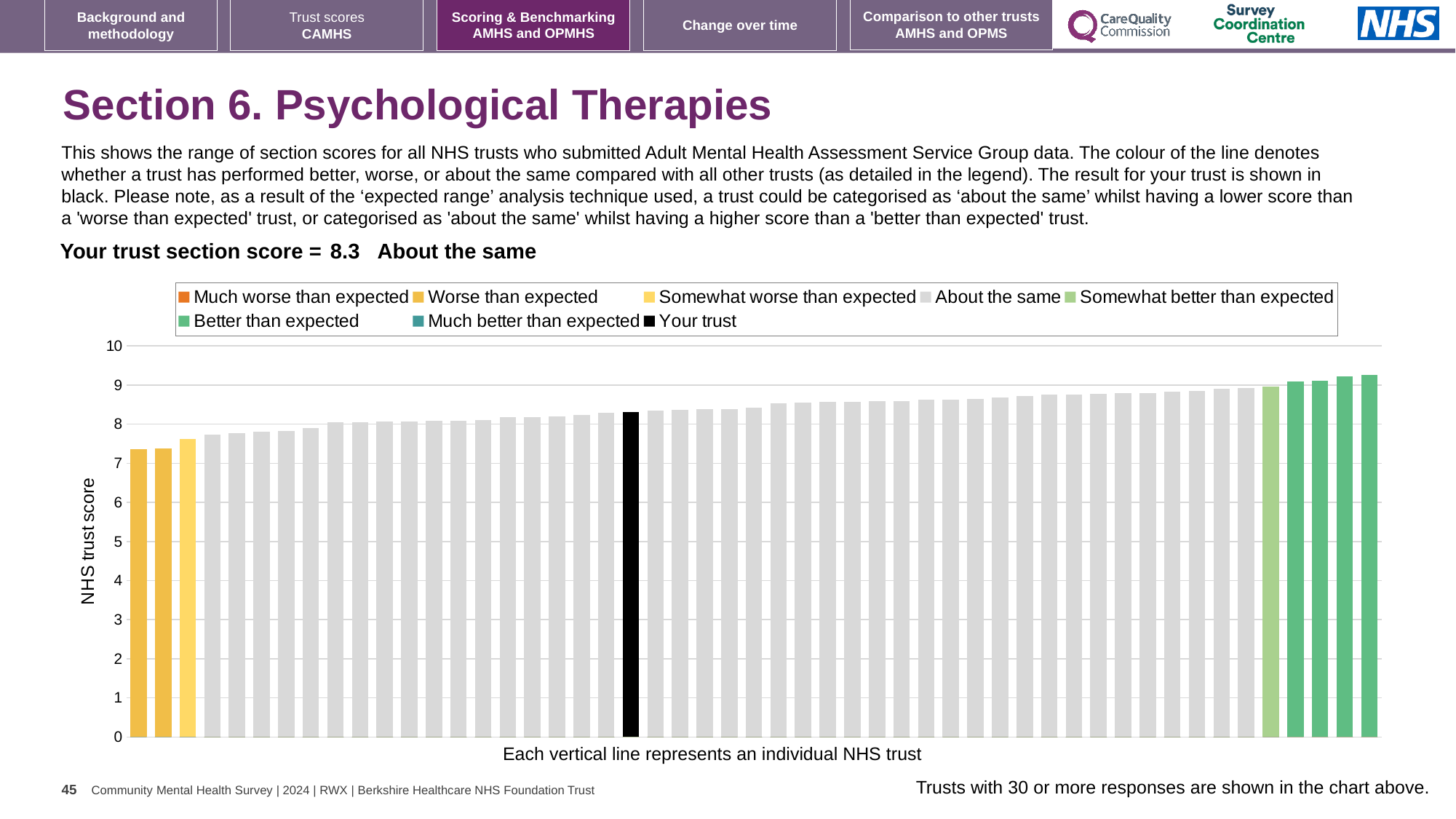
Do the bar values rise or fall from left to right along the x axis? rise How is your trust's section score categorised compared with other trusts? About the same Which colour in the legend represents your trust? black Is the value of the black bar (your trust) greater or less than 8? greater Is the value of the leftmost bar greater or less than 8? less Is the value of the tallest bar greater or less than 9? greater How many entries does the legend list? 8 What is the section score for your trust? 8.3 What kind of chart is shown on the slide? bar chart What is the label on the vertical axis? NHS trust score